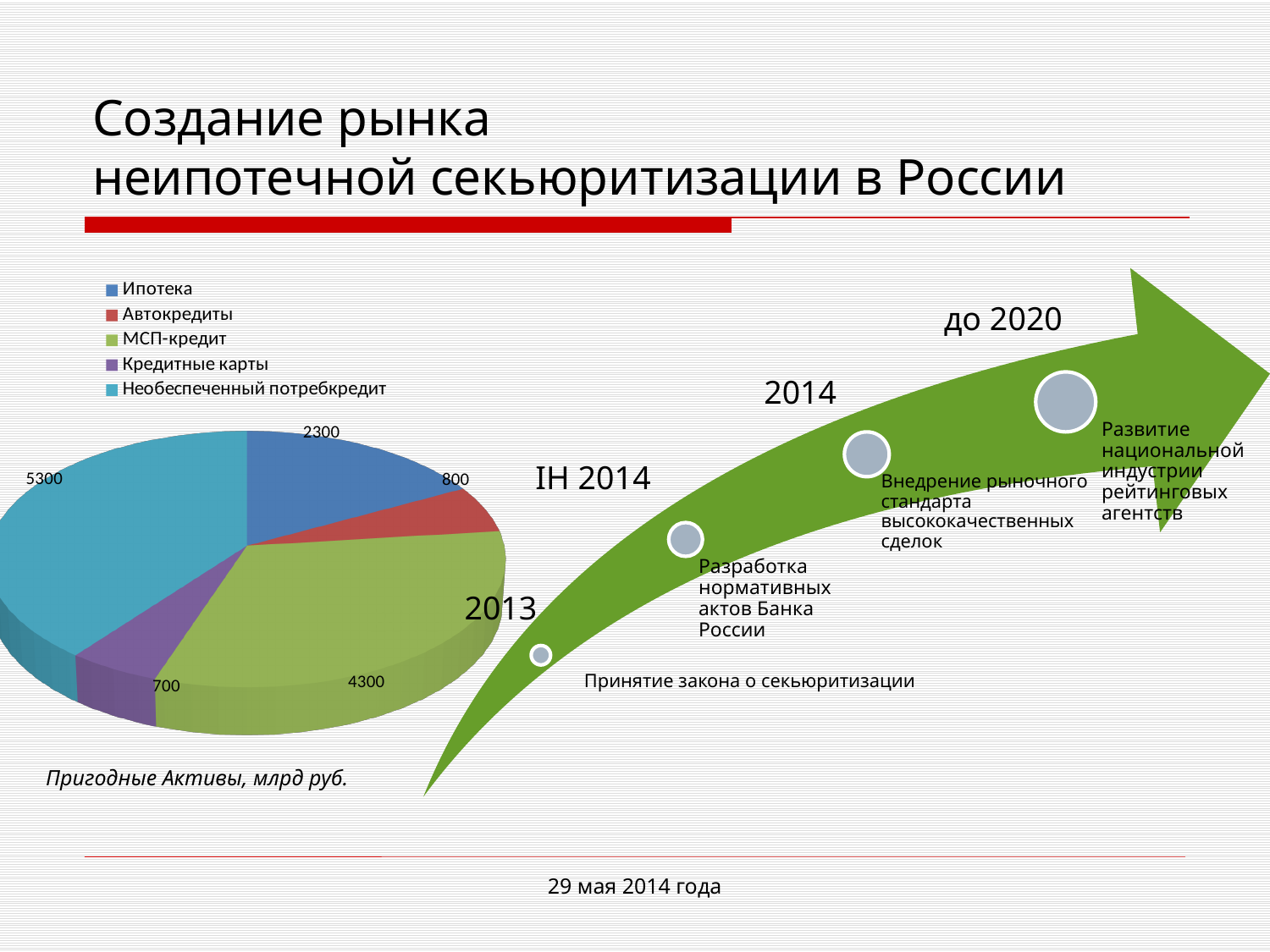
How many categories does the pie chart's legend list? 5 What is the value for Автокредиты in the pie chart? 800 Which category has the largest slice in the pie chart? Необеспеченный потребкредит Which is larger in the pie chart, Ипотека or Автокредиты? Ипотека What is the value for МСП-кредит in the pie chart? 4300 What is the value for Необеспеченный потребкредит in the pie chart? 5300 What caption is written below the pie chart? Пригодные Активы, млрд руб. What is the difference between the values for Необеспеченный потребкредит and МСП-кредит in the pie chart? 1000 What kind of chart is shown on the left of the slide? Pie chart Which category has the smallest slice in the pie chart? Кредитные карты What is the value for Ипотека in the pie chart? 2300 What is the total of all slices in the pie chart? 13400